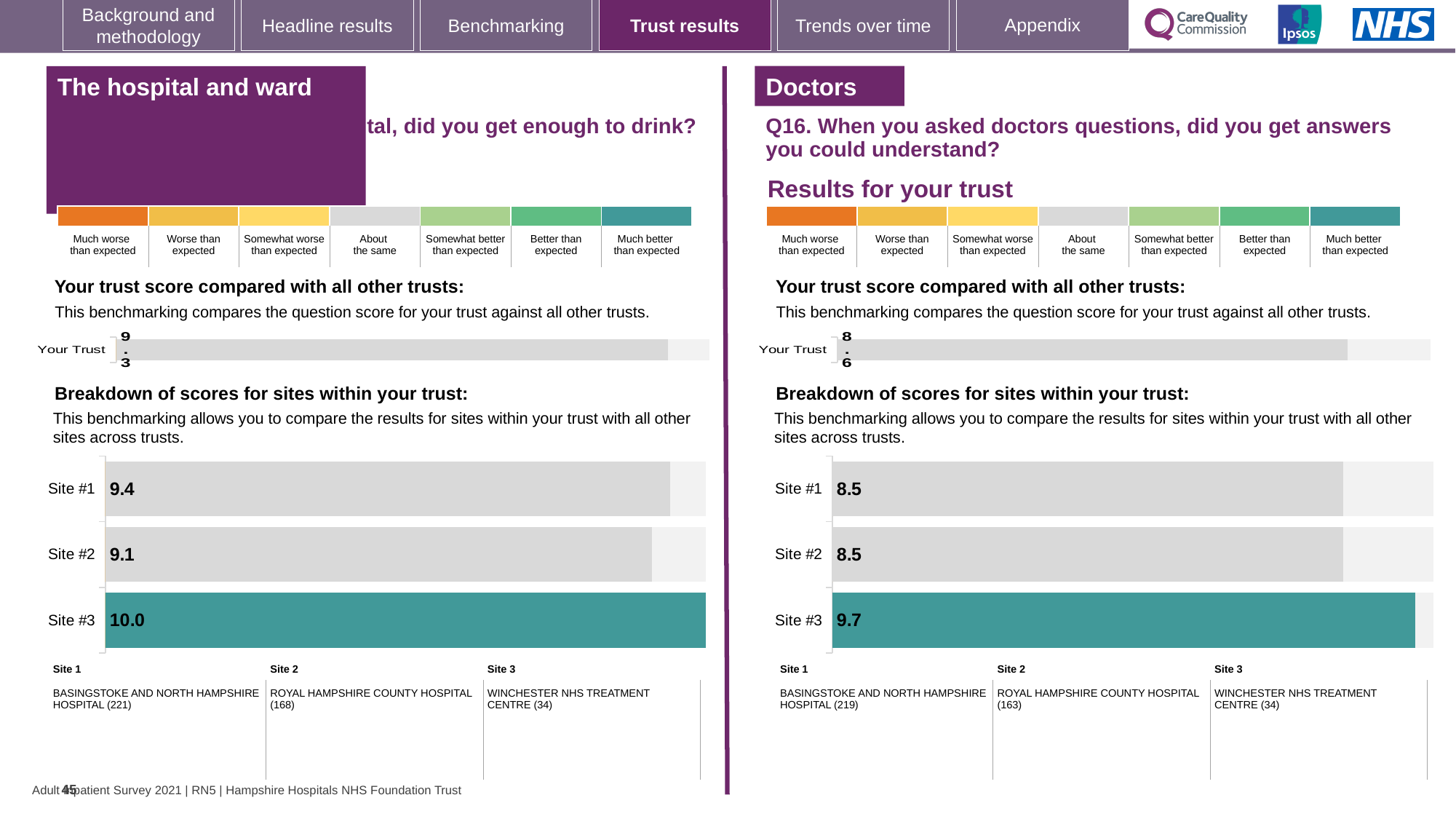
In the site breakdown chart on the left-hand side of the slide, which site has the highest score? Site #3 In the site breakdown chart on the left-hand side of the slide, what is the difference between the scores for Site #3 and Site #2? 0.9 In the site breakdown chart on the right-hand side of the slide (Doctors, Q16), which site has the highest score? Site #3 In the 'Breakdown of scores for sites within your trust' chart on the right-hand side of the slide (Doctors, Q16), what is the score for Site #1? 8.5 In the 'Your trust score compared with all other trusts' chart on the right-hand side of the slide (Doctors, Q16), what is the score shown for Your Trust? 8.6 In the 'Your trust score compared with all other trusts' chart on the left-hand side of the slide, what is the score shown for Your Trust? 9.3 In the site breakdown chart on the right-hand side of the slide (Doctors, Q16), what is the difference between the scores for Site #3 and Site #1? 1.2 In the 'Breakdown of scores for sites within your trust' chart on the left-hand side of the slide, what is the score for Site #3? 10.0 In the 'Breakdown of scores for sites within your trust' chart on the right-hand side of the slide (Doctors, Q16), what is the score for Site #3? 9.7 How many sites are shown in the site breakdown chart on the left-hand side of the slide? 3 In the 'Breakdown of scores for sites within your trust' chart on the left-hand side of the slide, what is the score for Site #2? 9.1 In the site breakdown chart on the left-hand side of the slide, which site has the lowest score? Site #2